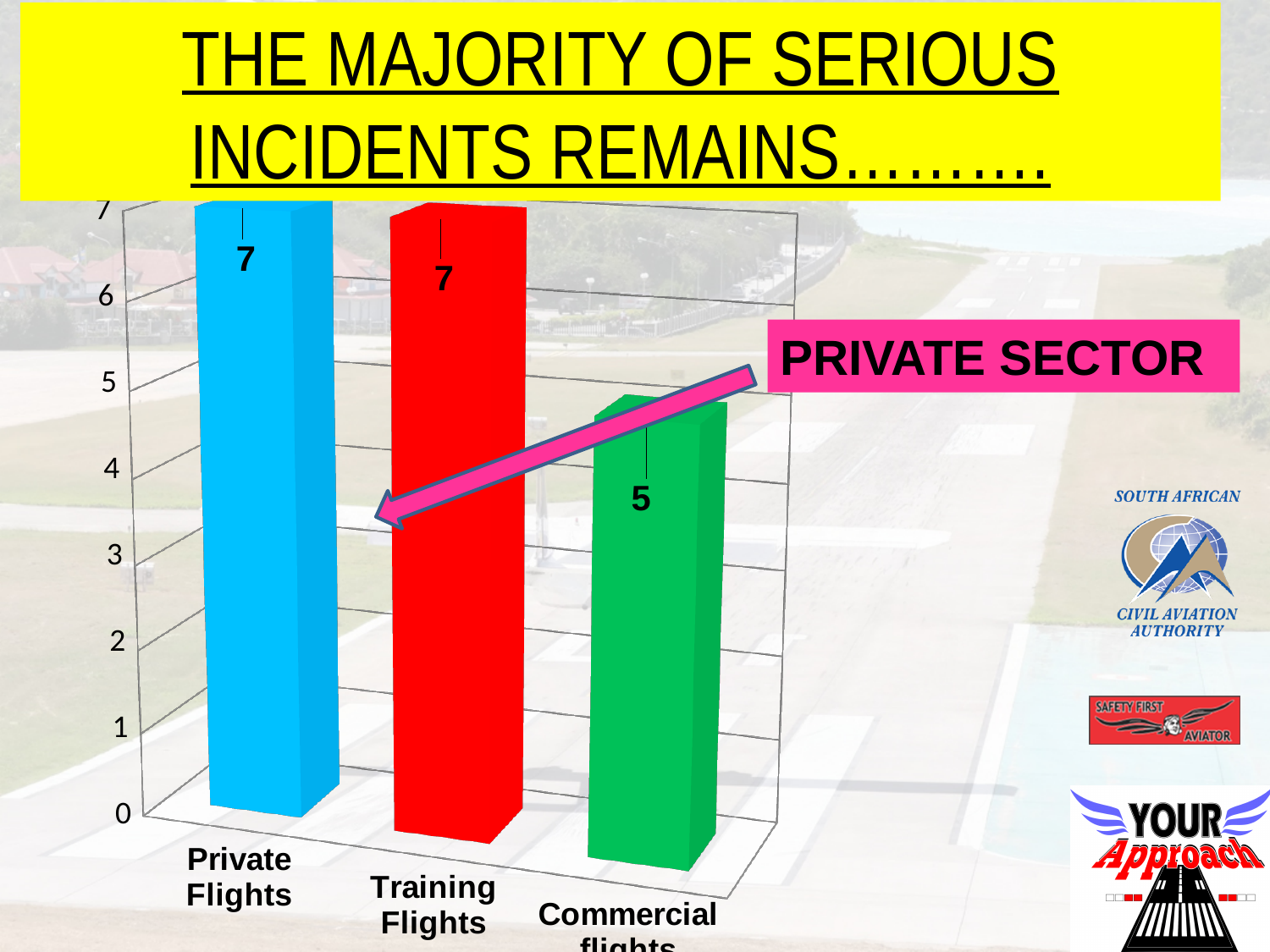
What is the total of the three values shown in the chart? 19 What is the value for Training Flights? 7 What kind of chart is shown on the slide? bar chart What text is in the pink callout box pointing at the chart? PRIVATE SECTOR What colour is the bar for Private Flights? blue Is the value for Commercial flights greater or less than 4? greater How many categories are shown in the chart? 3 What is the value for Private Flights? 7 Which is larger, the value for Training Flights or the value for Commercial flights? Training Flights Which category has the lowest value? Commercial flights What is the value for Commercial flights? 5 What is the difference between the values for Private Flights and Commercial flights? 2